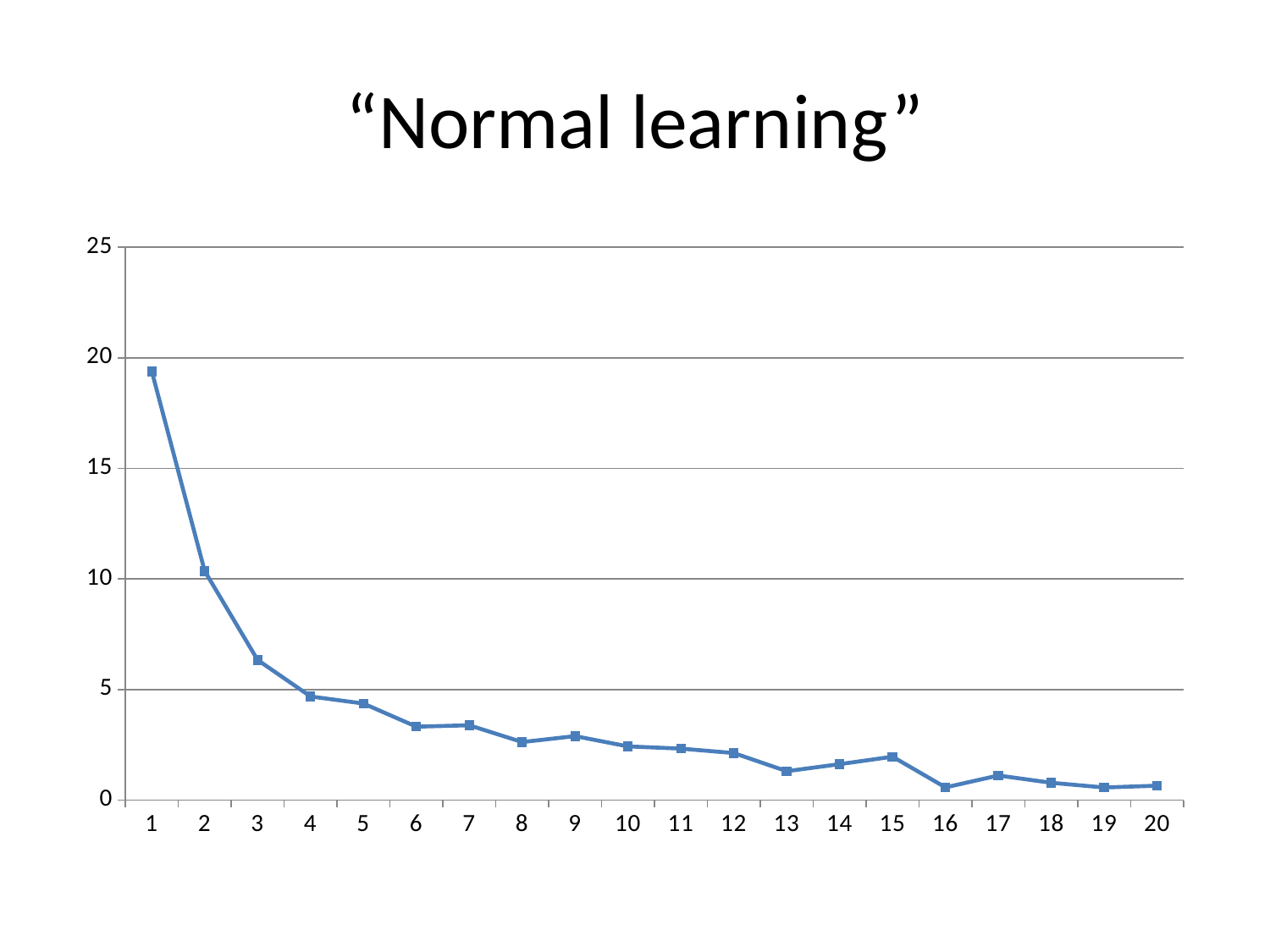
Is the value at x = 3 greater or less than 5? greater Do the values generally rise or fall as the x axis goes from 1 to 20? fall Which is larger, the value at x = 2 or the value at x = 3? x = 2 How many data points are plotted on the line? 20 Which x-axis category has the highest value? 1 Which is larger, the value at x = 15 or the value at x = 16? x = 15 Is the value at x = 1 greater or less than 15? greater Is the value at x = 16 greater or less than 5? less What is the title of the chart on the slide? "Normal learning" What kind of chart is shown on the slide? line chart